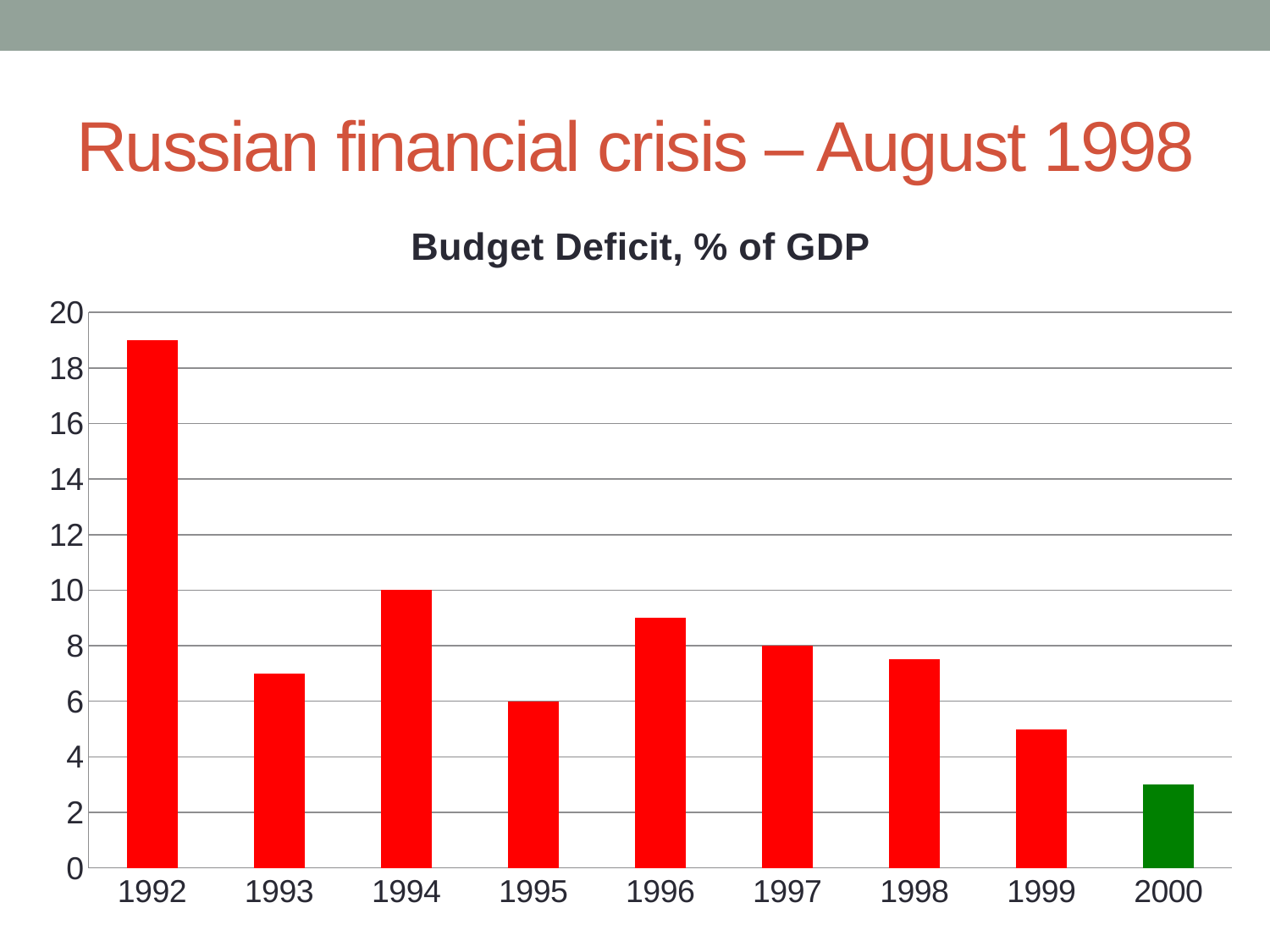
What is the difference between the budget deficit in 1994 and in 1995? 4 Is the value for 2000 greater or less than 4? less What is the budget deficit as % of GDP in 1995? 6 Which year has a larger budget deficit, 1996 or 1999? 1996 Is the value for 1992 greater or less than 18? greater What is the budget deficit as % of GDP in 1994? 10 What is the title of the chart? Budget Deficit, % of GDP What is the budget deficit as % of GDP in 1997? 8 How many years are shown on the x axis of the chart? 9 What type of chart is shown on the slide? Bar chart Which year has the lowest budget deficit? 2000 Which year has the highest budget deficit? 1992